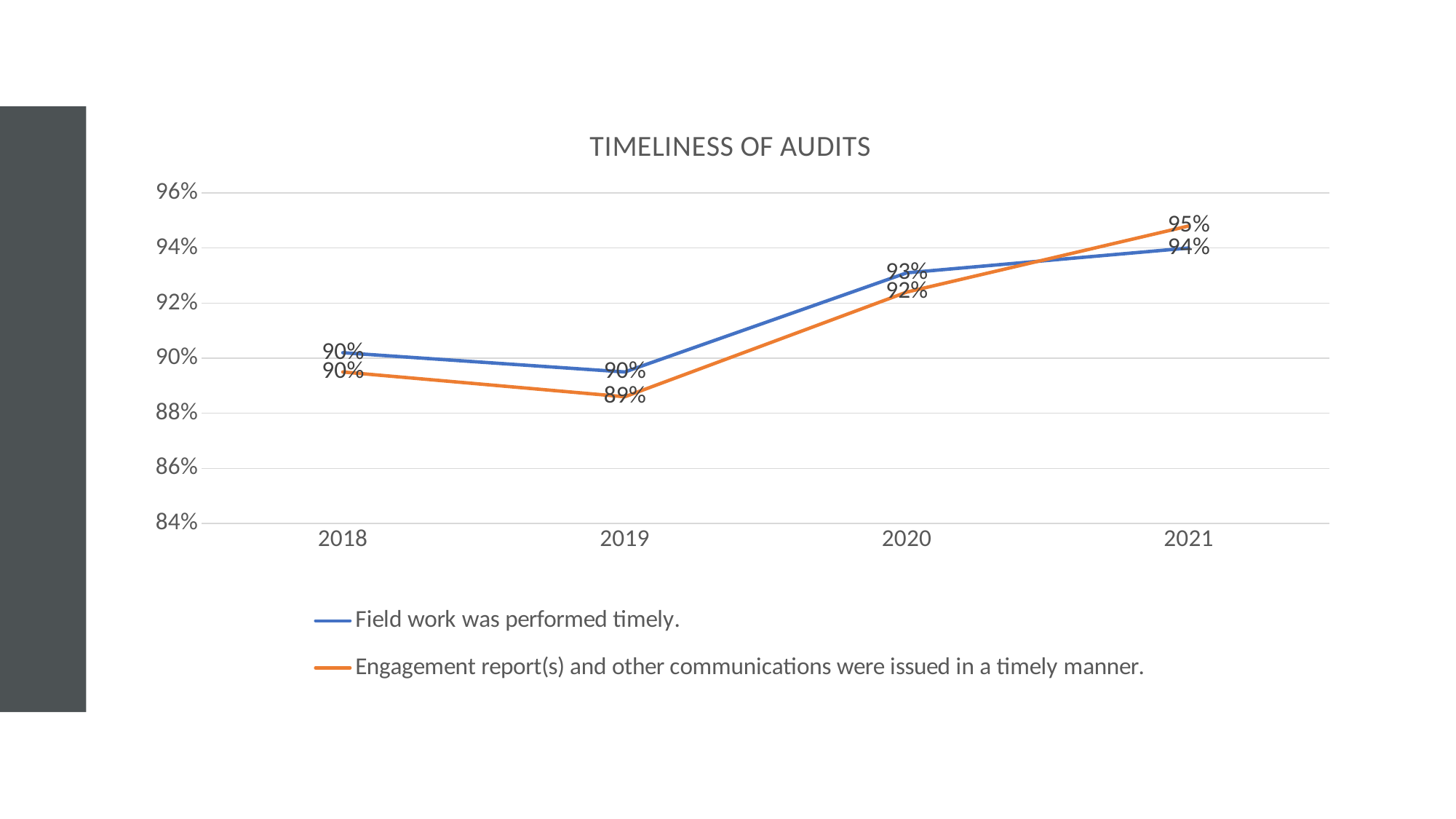
What is the value for 'Field work was performed timely.' in 2020? 93% What is the difference between the 2021 and 2019 values for 'Engagement report(s) and other communications were issued in a timely manner.'? 6% In 2021, which series has the higher value: 'Field work was performed timely.' or 'Engagement report(s) and other communications were issued in a timely manner.'? Engagement report(s) and other communications were issued in a timely manner. In which year is the 'Field work was performed timely.' series highest? 2021 Does the 'Field work was performed timely.' series rise or fall from 2019 to 2021? rise What is the title of the chart? TIMELINESS OF AUDITS What is the value for 'Engagement report(s) and other communications were issued in a timely manner.' in 2019? 89% What type of chart is shown on the slide? line chart How many years are plotted on the x axis? 4 In which year is the 'Engagement report(s) and other communications were issued in a timely manner.' series lowest? 2019 What is the value for 'Engagement report(s) and other communications were issued in a timely manner.' in 2021? 95% How many series does the legend list? 2